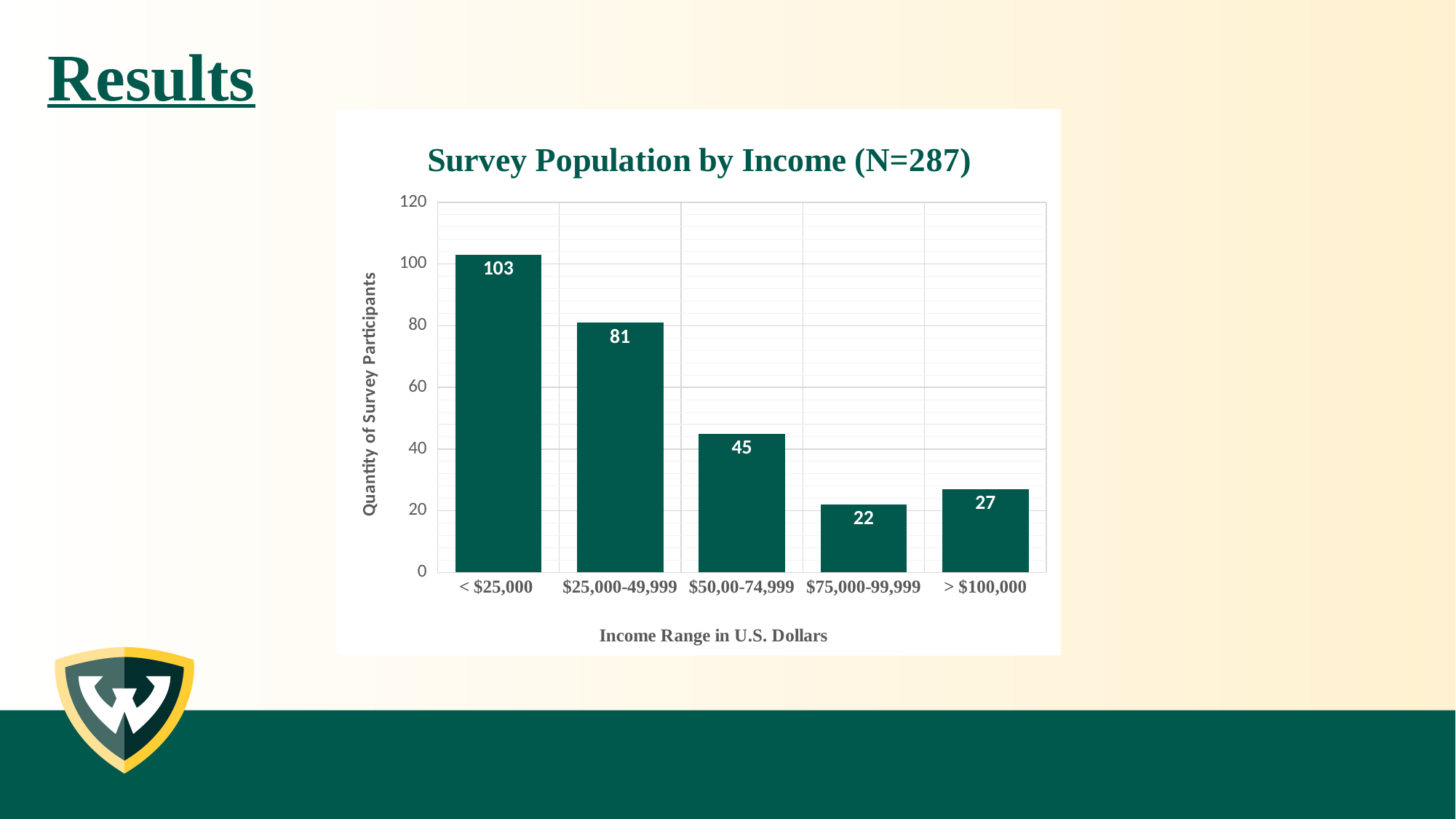
What is the number of survey participants in the < $25,000 income range? 103 Is the value for the $50,00-74,999 income range greater or less than 60? less Which income range has the highest number of survey participants? < $25,000 What is the number of survey participants in the > $100,000 income range? 27 How many income ranges are shown on the chart? 5 Which income range has the lowest number of survey participants? $75,000-99,999 What kind of chart is shown on the slide? bar chart What is the number of survey participants in the $25,000-49,999 income range? 81 What is the number of survey participants in the $75,000-99,999 income range? 22 What is the title of the chart? Survey Population by Income (N=287) Which has more survey participants: the $50,00-74,999 range or the > $100,000 range? $50,00-74,999 What is the difference in participants between the < $25,000 and $25,000-49,999 income ranges? 22